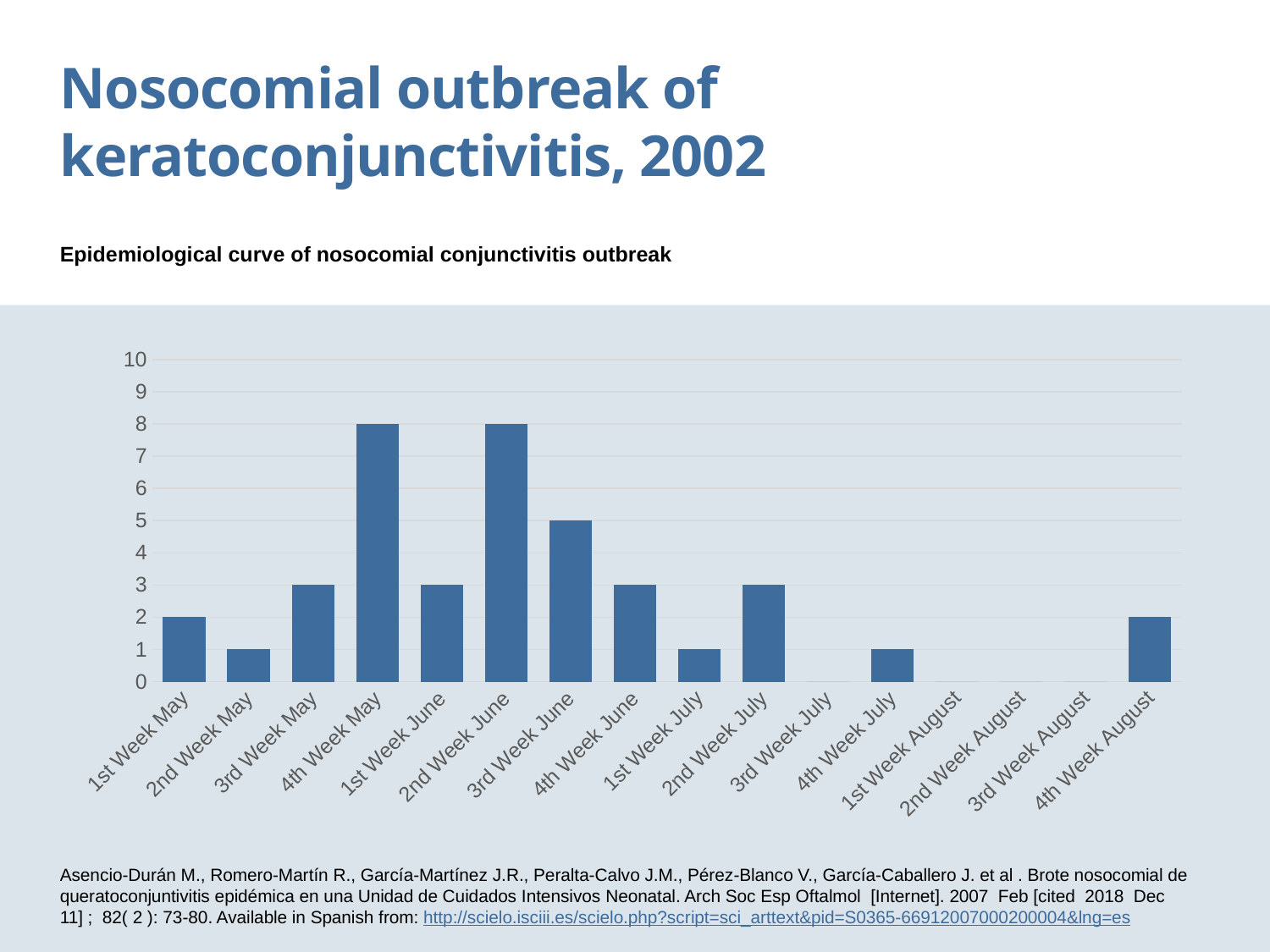
What is the difference between the values for 2nd Week June and 3rd Week June? 3 What is the value for 2nd Week July? 3 Which is larger, the value for 3rd Week June or the value for 4th Week June? 3rd Week June What is the value for 3rd Week June? 5 What is the difference between the values for 4th Week May and 3rd Week May? 5 How many weeks are shown on the x axis? 16 What is the value for 4th Week August? 2 What is the title of the chart? Epidemiological curve of nosocomial conjunctivitis outbreak Is the value for 2nd Week June greater or less than 5? greater What kind of chart is shown on the slide? bar chart What is the value for 4th Week May? 8 What is the value for 1st Week May? 2